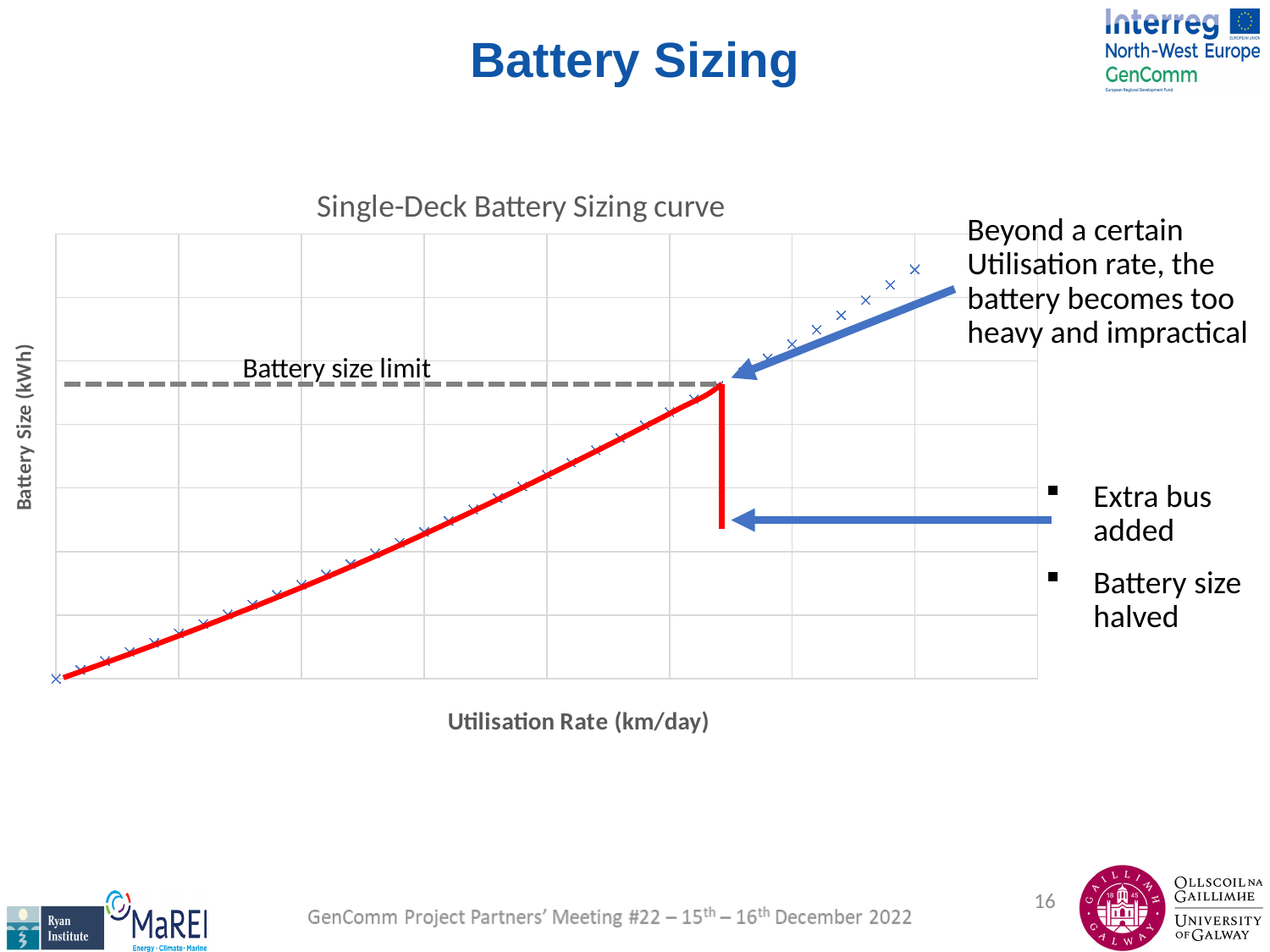
What kind of chart is shown on the slide? scatter chart Do the plotted battery size values rise or fall as the utilisation rate increases along the x axis? rise What is the title of the chart on the slide? Single-Deck Battery Sizing curve What is the label of the vertical axis of the chart? Battery Size (kWh)